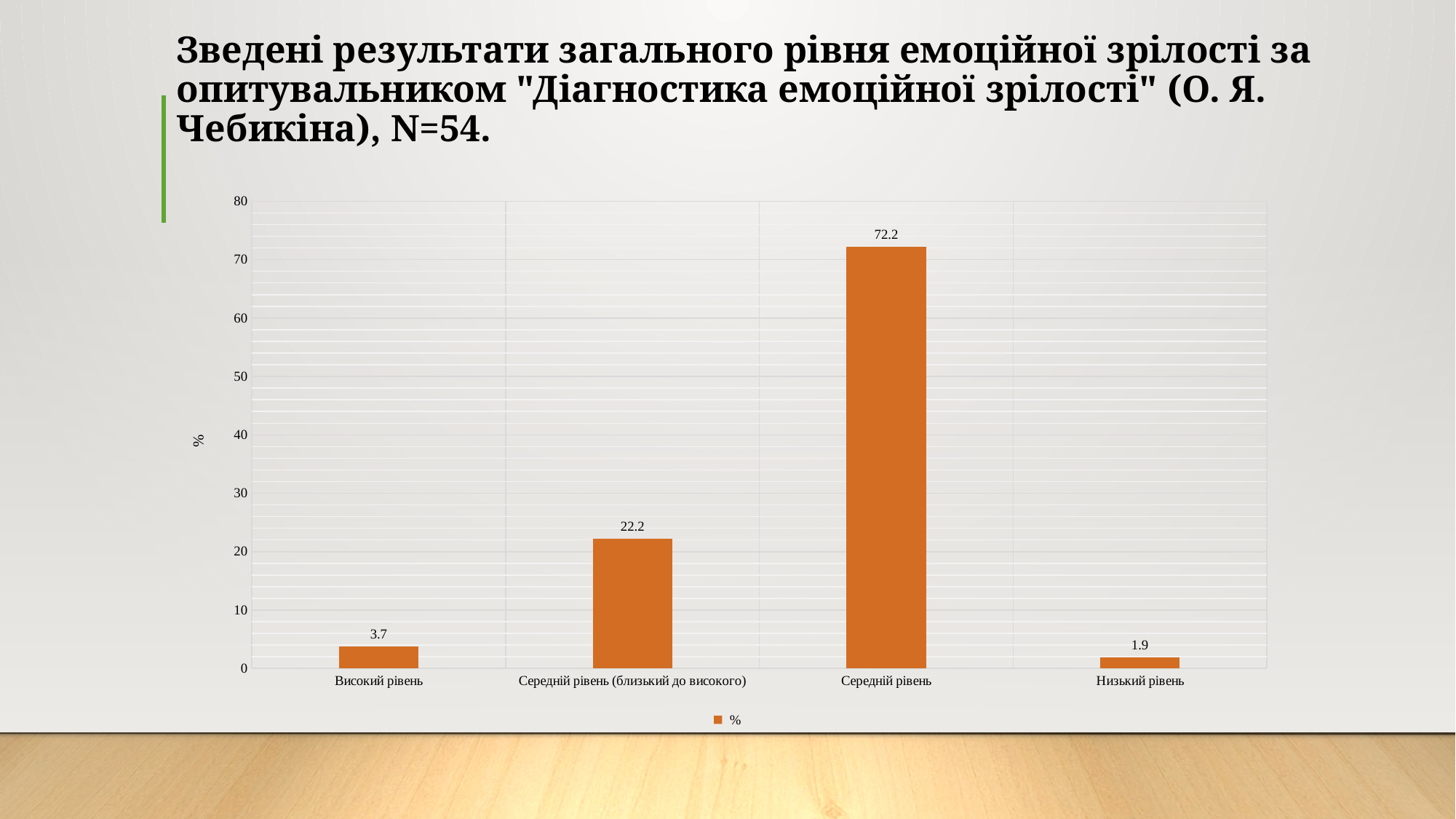
Which is larger, the value for Високий рівень or the value for Низький рівень? Високий рівень Which category has the highest value? Середній рівень What is the value for Середній рівень? 72.2 What is the value for Високий рівень? 3.7 What is the difference between the values for Середній рівень and Середній рівень (близький до високого)? 50 How many categories are shown on the x axis? 4 Is the value for Середній рівень greater or less than 70? greater What is the value for Середній рівень (близький до високого)? 22.2 What is the value for Низький рівень? 1.9 Which category has the lowest value? Низький рівень What kind of chart is shown on the slide? bar chart What is the label of the series shown in the legend? %